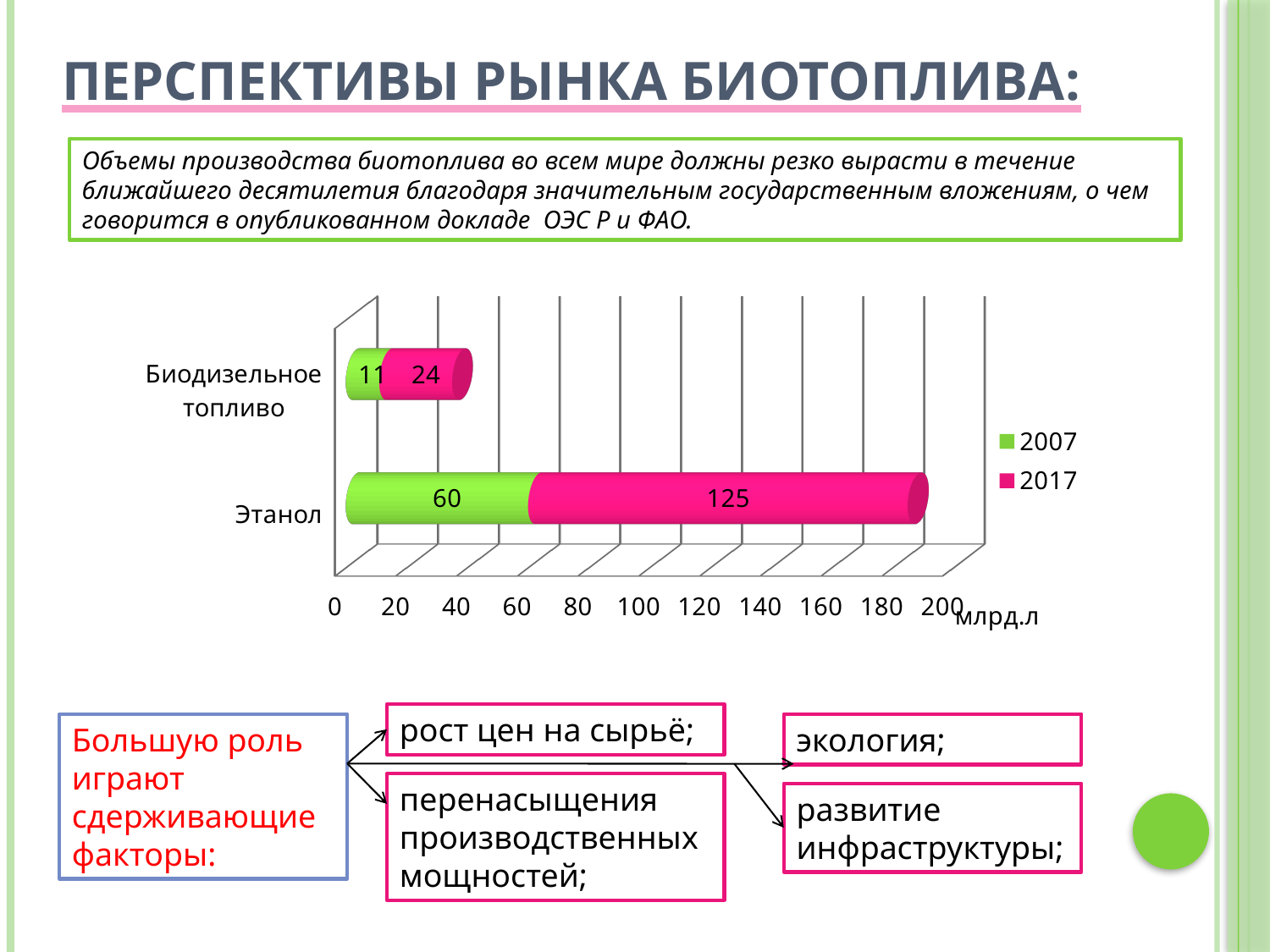
What kind of chart is shown on the slide? Stacked bar chart What is the difference between the 2017 and 2007 values for Этанол? 65 Which category has the highest value in the 2017 series? Этанол What is the value for Биодизельное топливо in the 2017 series? 24 What is the value for Биодизельное топливо in the 2007 series? 11 What is the total of the stacked bar for Этанол? 185 What is the value for Этанол in the 2017 series? 125 Which category has the lowest value in the 2007 series? Биодизельное топливо What is the value for Этанол in the 2007 series? 60 Which is larger: the 2017 value for Биодизельное топливо or the 2007 value for Этанол? 2007 value for Этанол How many series does the legend list? 2 What is the total of the stacked bar for Биодизельное топливо? 35